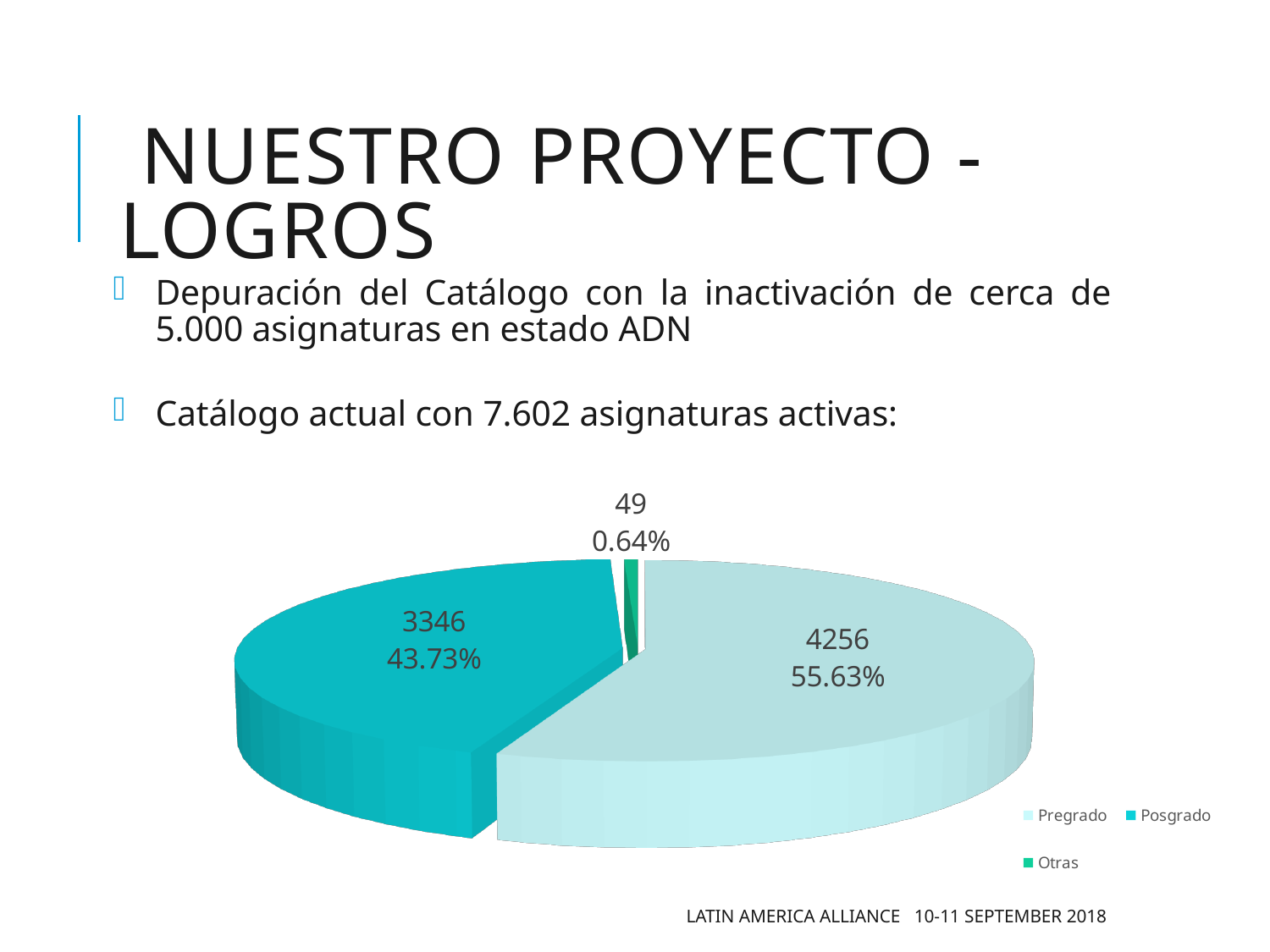
Which category has the smallest slice? Otras Which category has the largest slice? Pregrado How many categories does the legend list? 3 What is the value for Posgrado? 3346 Which is larger, the value for Posgrado or the value for Otras? Posgrado What is the value for Otras? 49 What kind of chart is shown on the slide? Pie chart What is the difference between the values for Pregrado and Posgrado? 910 What share of the pie does Otras represent? 0.64% What share of the pie does Posgrado represent? 43.73% What share of the pie does Pregrado represent? 55.63% What is the value for Pregrado? 4256